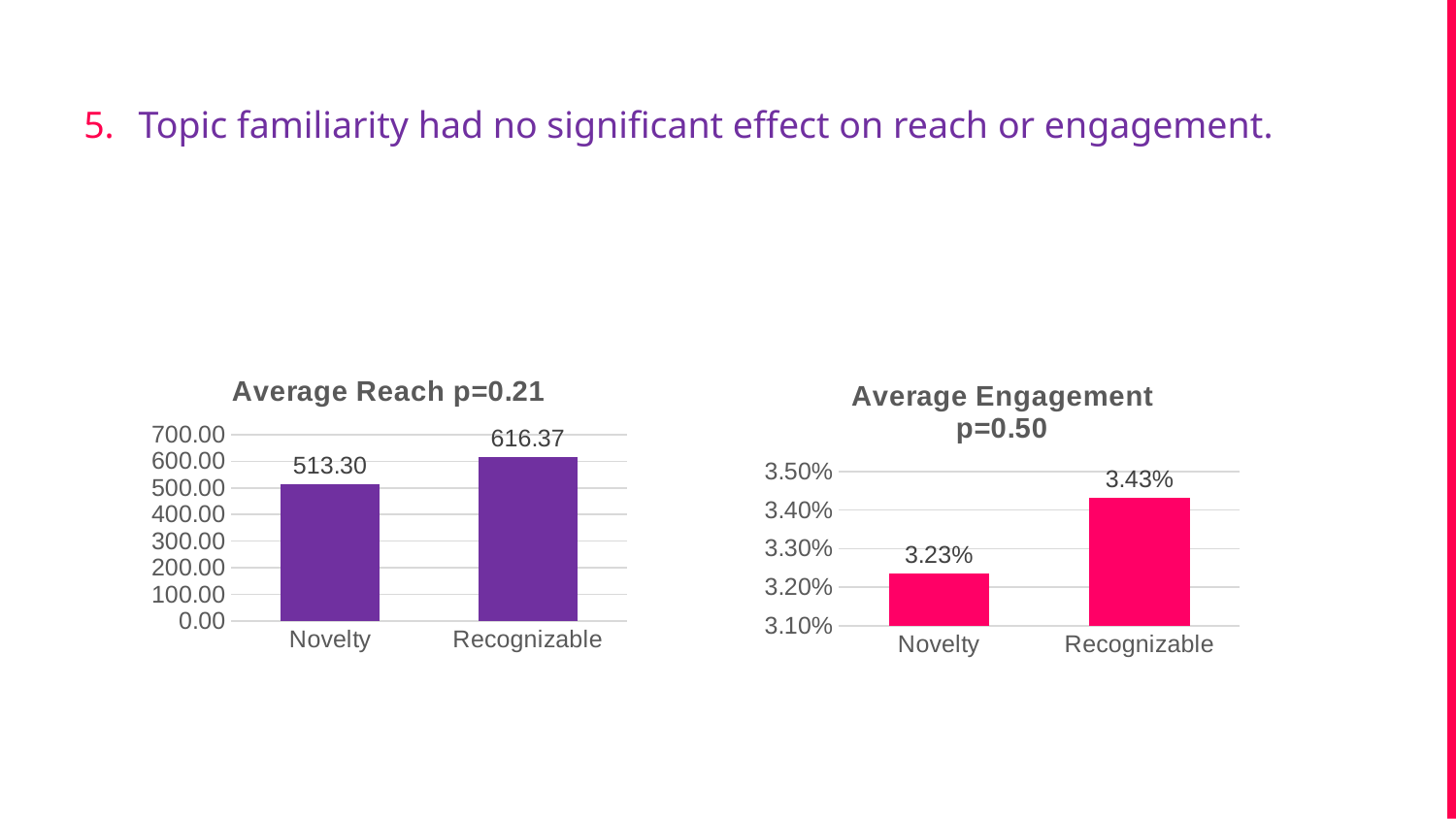
In the Average Engagement p=0.50 chart, what is the value for Recognizable? 3.43% What colour are the bars in the Average Engagement p=0.50 chart? pink In the Average Engagement p=0.50 chart, what is the value for Novelty? 3.23% In the Average Reach p=0.21 chart, which category has the highest value? Recognizable What kind of chart is the Average Reach p=0.21 chart? bar chart In the Average Reach p=0.21 chart, what is the value for Novelty? 513.30 In the Average Reach p=0.21 chart, what is the value for Recognizable? 616.37 In the Average Engagement p=0.50 chart, what is the difference between the Recognizable and Novelty values? 0.20% In the Average Reach p=0.21 chart, is the value for Novelty greater or less than 600.00? less How many categories are shown in the Average Engagement p=0.50 chart? 2 In the Average Engagement p=0.50 chart, which category has the lowest value? Novelty In the Average Reach p=0.21 chart, what is the difference between the Recognizable and Novelty values? 103.07